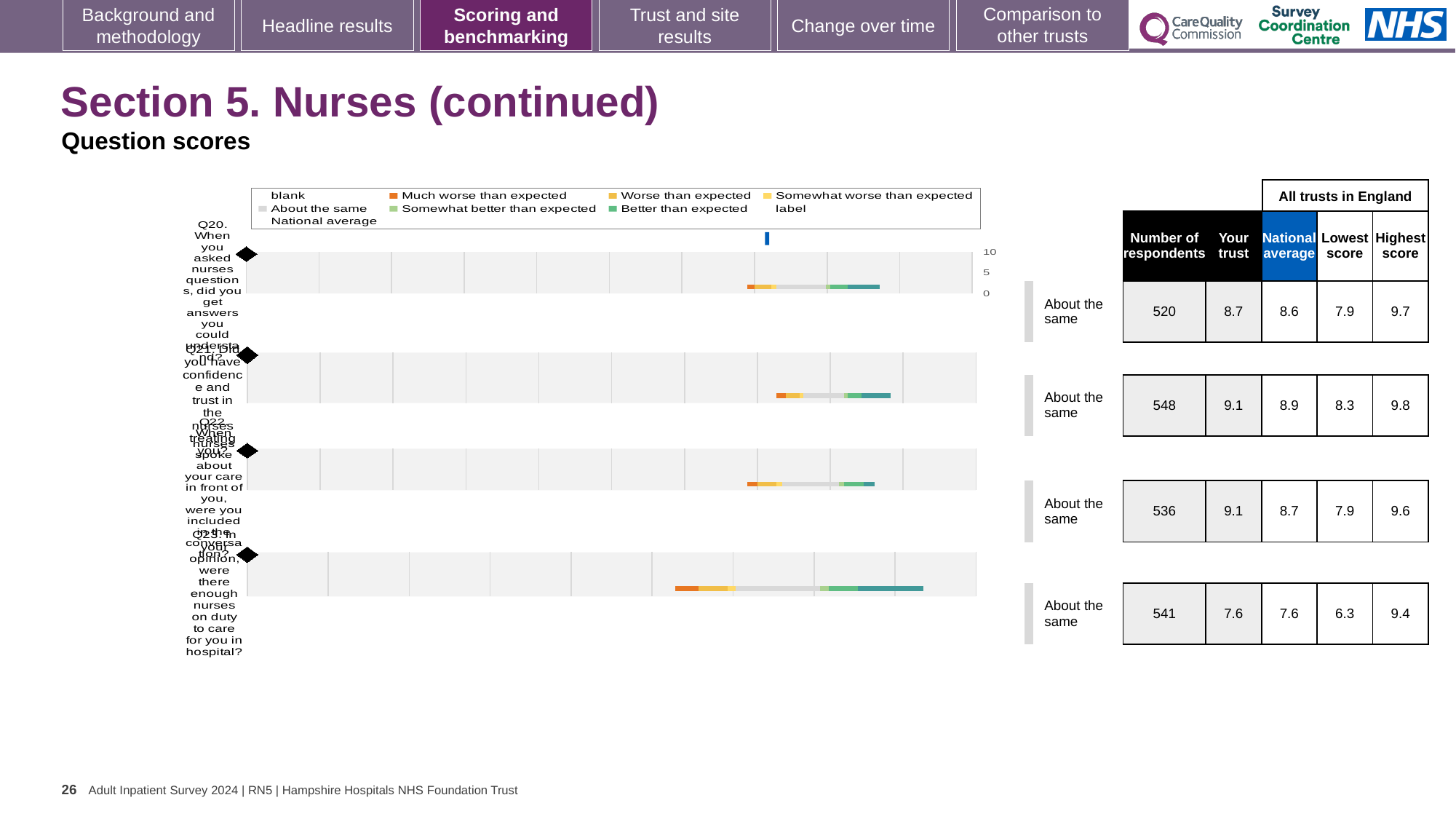
What is the number of respondents for Q22? 536 What kind of chart is used for the question scores on this slide? bar chart What is the 'Your trust' score for Q20 (When you asked nurses questions, did you get answers you could understand)? 8.7 What is the highest value shown on the chart's axis? 10 What is the difference between the highest score (9.8) and the lowest score (8.3) for Q21? 1.5 What is the lowest score across all trusts in England for Q23 (were there enough nurses on duty)? 6.3 How many questions (Q20 to Q23) are plotted on this slide? 4 Which question has the lowest 'Your trust' score? Q23 What is the national average for Q21 (Did you have confidence and trust in the nurses treating you)? 8.9 Which question has the highest number of respondents? Q21 Is the 'Your trust' score for Q22 larger or smaller than the national average for Q22? larger Which legend entry is shown in orange? Much worse than expected